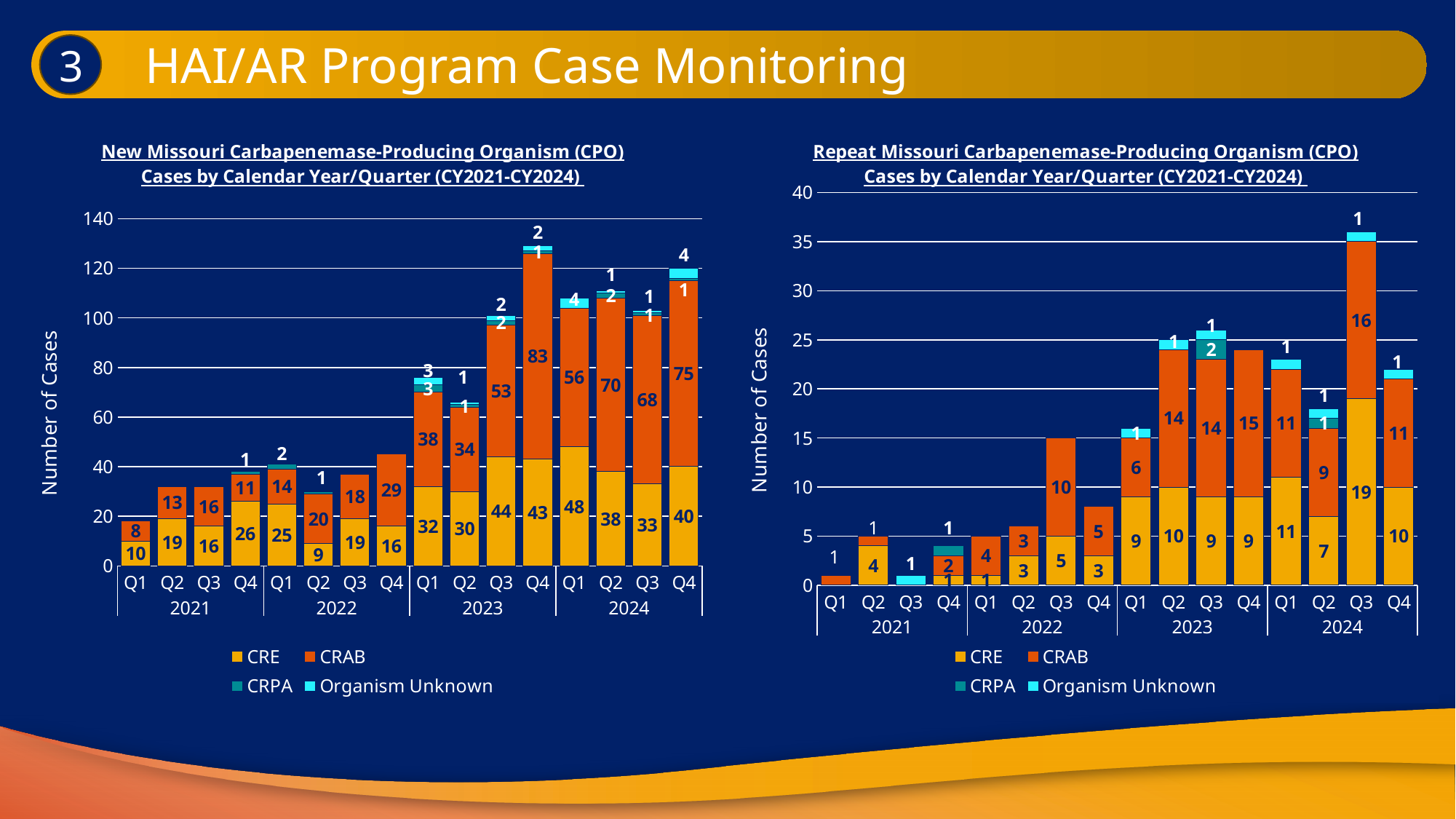
In the New Missouri CPO Cases chart, what is the difference between CRAB cases in Q4 2023 and CRAB cases in Q3 2023? 30 In the Repeat Missouri CPO Cases chart, which quarter has the tallest stacked bar? Q3 2024 In the Repeat Missouri CPO Cases chart, what is the total number of cases in Q4 2023? 24 In the New Missouri CPO Cases chart, how many CRE cases were reported in Q1 2024? 48 In the New Missouri CPO Cases chart, how many CRAB cases were reported in Q4 2023? 83 In the Repeat Missouri CPO Cases chart, how many CRAB cases were reported in Q3 2022? 10 In the Repeat Missouri CPO Cases chart, how many CRE cases were reported in Q3 2024? 19 In the New Missouri CPO Cases chart, what is the total number of cases in Q3 2022? 37 How many series does the legend of the Repeat Missouri CPO Cases chart list? 4 In the New Missouri CPO Cases chart, which quarter has the tallest stacked bar? Q4 2023 In the New Missouri CPO Cases chart, which is larger: CRE cases in Q1 2024 or CRE cases in Q4 2023? CRE cases in Q1 2024 In the New Missouri CPO Cases chart, is the total for Q4 2022 greater or less than 40? greater